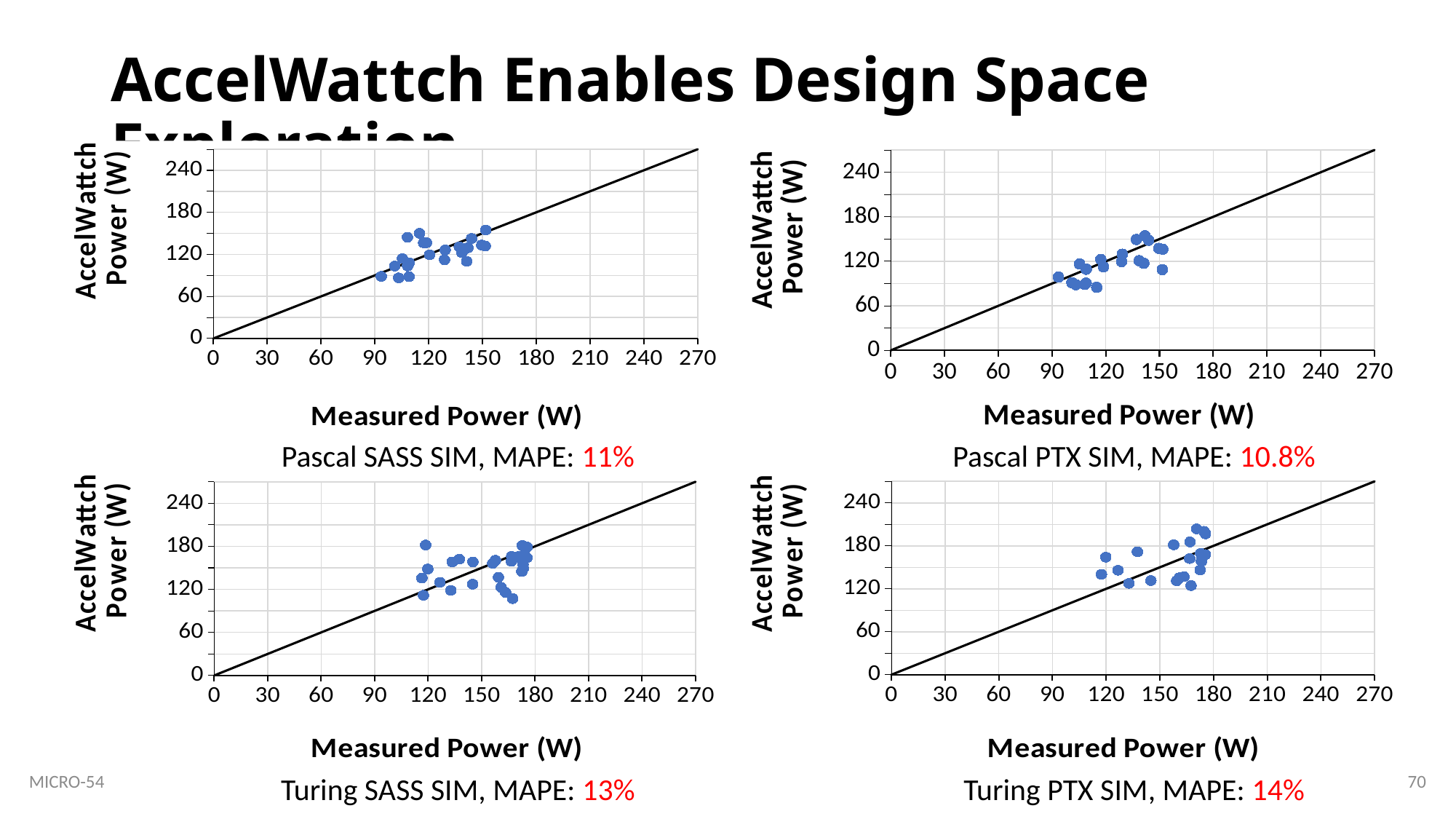
What kind of chart is the top-left chart labelled Pascal SASS SIM? scatter chart What MAPE is reported for the Pascal SASS SIM chart (top left)? 11% What is the y-axis label of the Pascal PTX SIM chart (top right)? AccelWattch Power (W) How many charts are shown on the slide? 4 What is the difference between the MAPE of the Turing PTX SIM chart and the Turing SASS SIM chart? 1% Which of the four charts reports the lowest MAPE? Pascal PTX SIM Which of the four charts reports the highest MAPE? Turing PTX SIM In the Turing SASS SIM chart (bottom left), are the measured power values of the plotted points greater or less than 90? greater What MAPE is reported for the Turing PTX SIM chart (bottom right)? 14% What is the x-axis label of the Turing PTX SIM chart (bottom right)? Measured Power (W) What MAPE is reported for the Pascal PTX SIM chart (top right)? 10.8% What MAPE is reported for the Turing SASS SIM chart (bottom left)? 13%